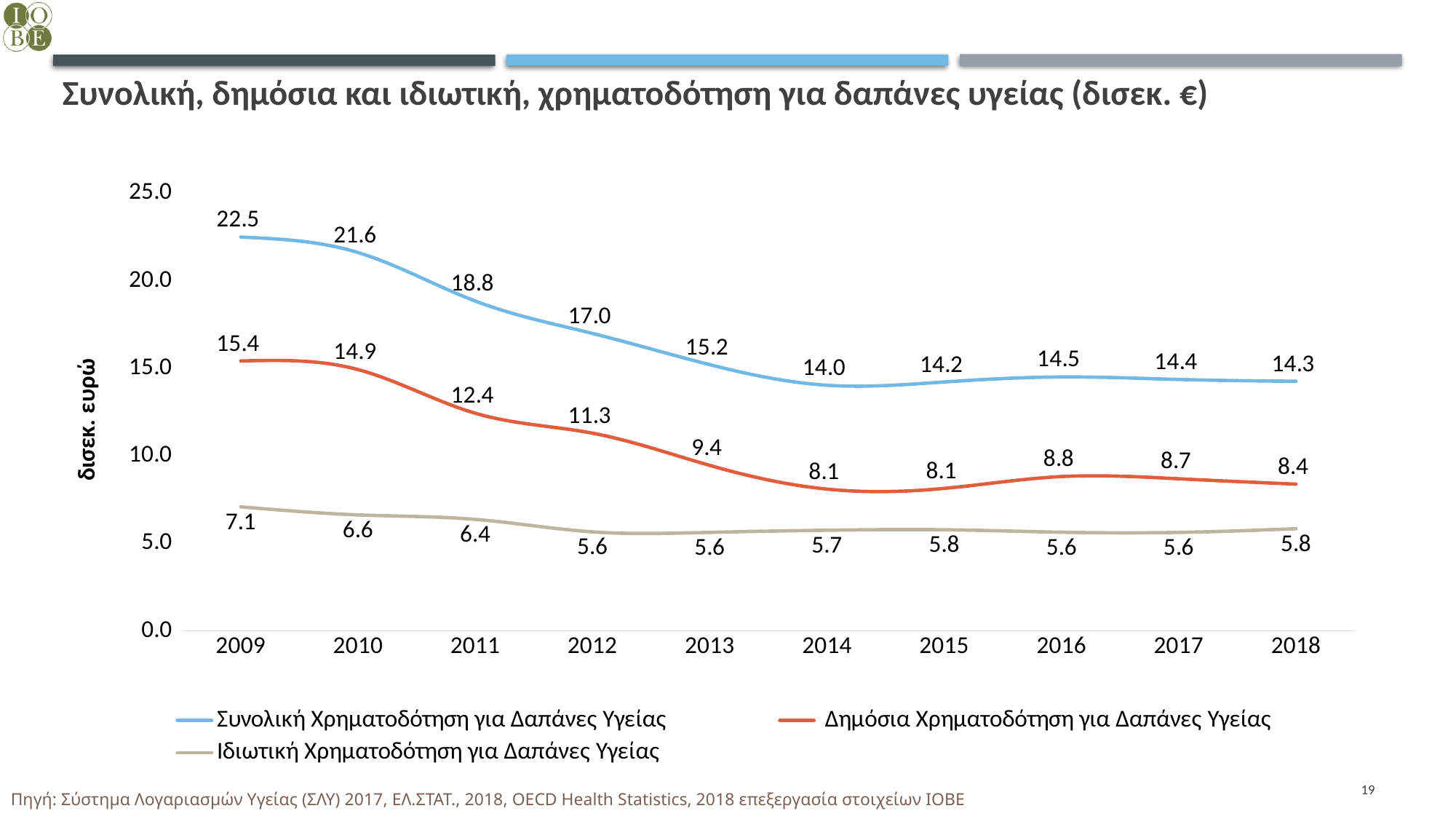
Which is larger: Δημόσια Χρηματοδότηση για Δαπάνες Υγείας in 2016 or in 2017? 2016 In which year is Συνολική Χρηματοδότηση για Δαπάνες Υγείας lowest? 2014 Does Συνολική Χρηματοδότηση για Δαπάνες Υγείας rise or fall from 2009 to 2014? fall How many years are shown on the x axis? 10 In which year is Δημόσια Χρηματοδότηση για Δαπάνες Υγείας highest? 2009 What is the label of the y axis? δισεκ. ευρώ What is the value of Ιδιωτική Χρηματοδότηση για Δαπάνες Υγείας in 2018? 5.8 What is the value of Συνολική Χρηματοδότηση για Δαπάνες Υγείας in 2009? 22.5 What type of chart is shown on the slide? line chart What is the difference between Συνολική Χρηματοδότηση για Δαπάνες Υγείας in 2009 and in 2018? 8.2 How many series does the legend list? 3 What is the value of Δημόσια Χρηματοδότηση για Δαπάνες Υγείας in 2013? 9.4